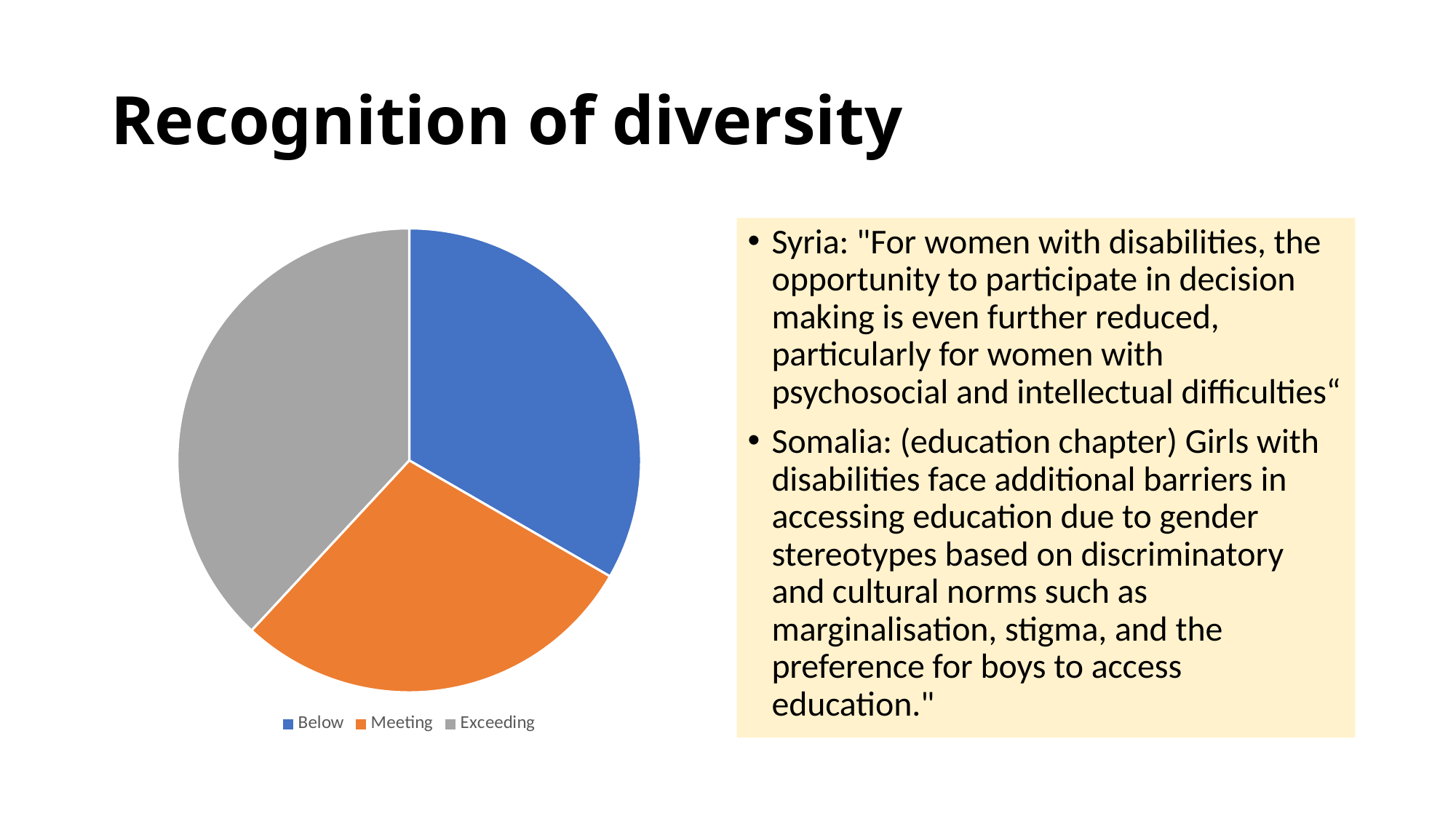
What kind of chart is shown on the slide? pie chart What are the three categories shown in the pie chart's legend? Below, Meeting, Exceeding How many slices does the pie chart have? 3 Which colour represents the 'Exceeding' slice in the pie chart? grey In the pie chart, which slice is larger: Exceeding or Meeting? Exceeding How many entries does the legend of the pie chart list? 3